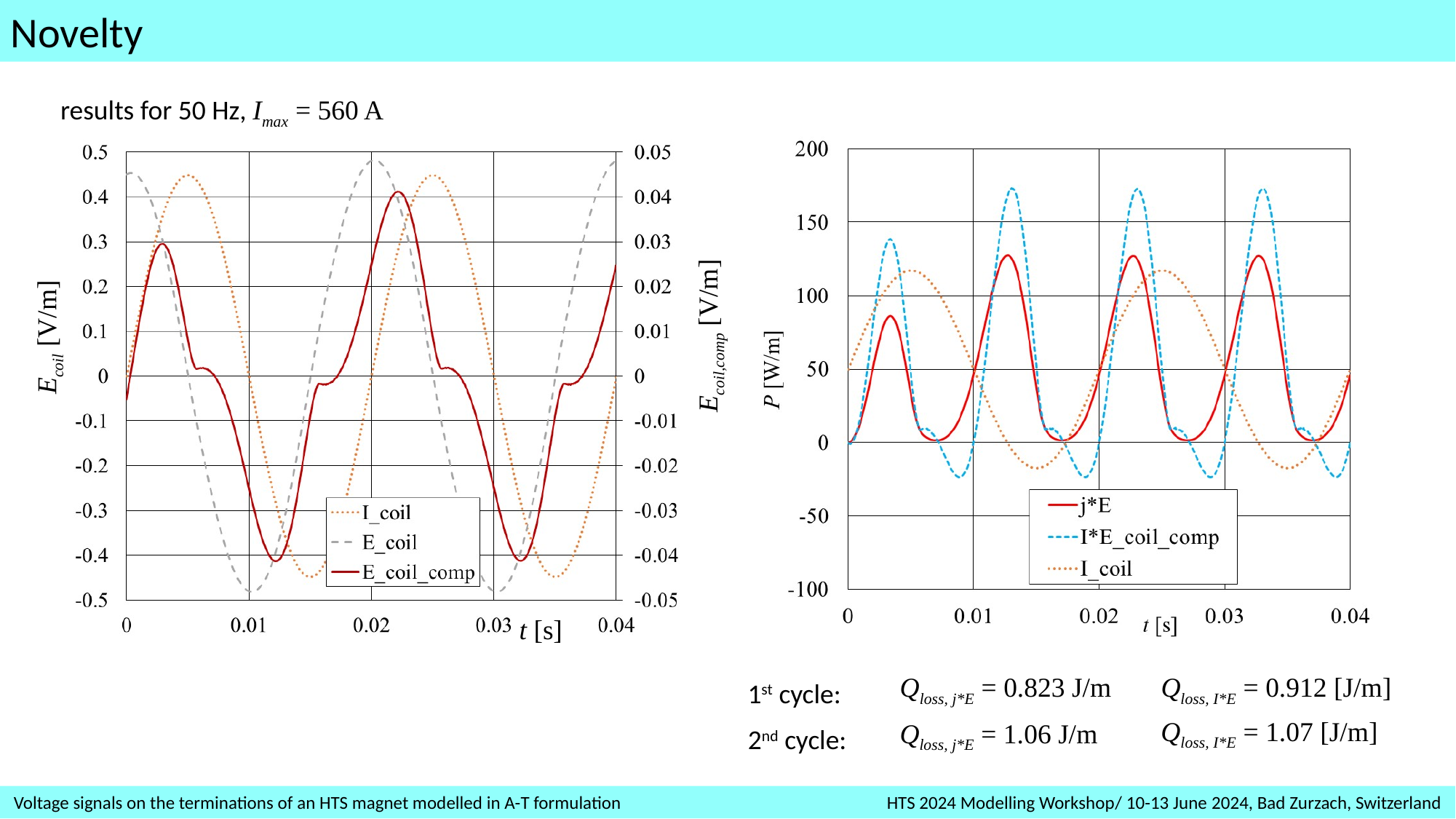
In the left chart, which series is drawn as a grey dashed line? E_coil In the right chart, is the first peak of j*E (near t = 0.003 s) greater or less than 100 W/m? less In the left chart, is the value of E_coil at t = 0 greater or less than 0.4 V/m on the left axis? greater How many series does the legend of the right chart list? 3 In the right chart, which series is drawn as a solid red line? j*E In the right chart, around t = 0.013 s, which series reaches the higher peak, j*E or I*E_coil_comp? I*E_coil_comp What kind of chart is the left chart (E_coil vs t)? line chart How many series does the legend of the left chart list? 3 What kind of chart is the right chart (P vs t)? line chart In the right chart, is the first peak of j*E higher or lower than its second peak? lower In the right chart, is the highest peak of I*E_coil_comp greater or less than 150 W/m? greater